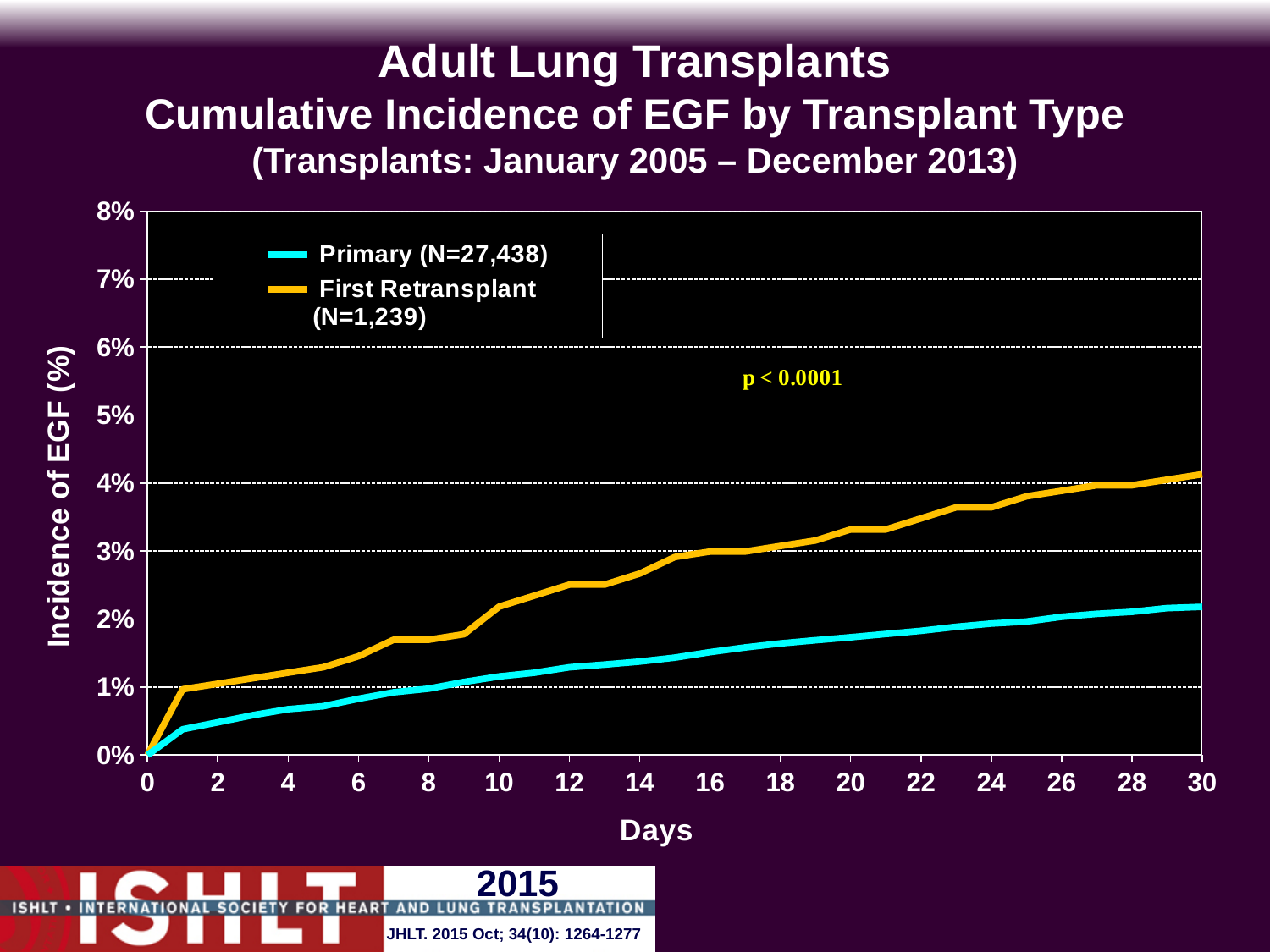
Does the cumulative incidence of EGF for First Retransplant rise or fall as days increase? rise Is the value for First Retransplant at day 30 greater or less than 3%? greater Which series has the higher cumulative incidence of EGF at day 30, Primary or First Retransplant? First Retransplant Is the value for First Retransplant at day 20 greater or less than 3%? greater Does the cumulative incidence of EGF for Primary rise or fall from day 0 to day 30? rise How many series does the legend list? 2 What is the N for the Primary series shown in the legend? 27,438 Is the value for Primary at day 20 greater or less than 2%? less What is the cumulative incidence of EGF for both series at day 0? 0% What kind of chart is shown on the slide? line chart What p-value is printed on the chart? p < 0.0001